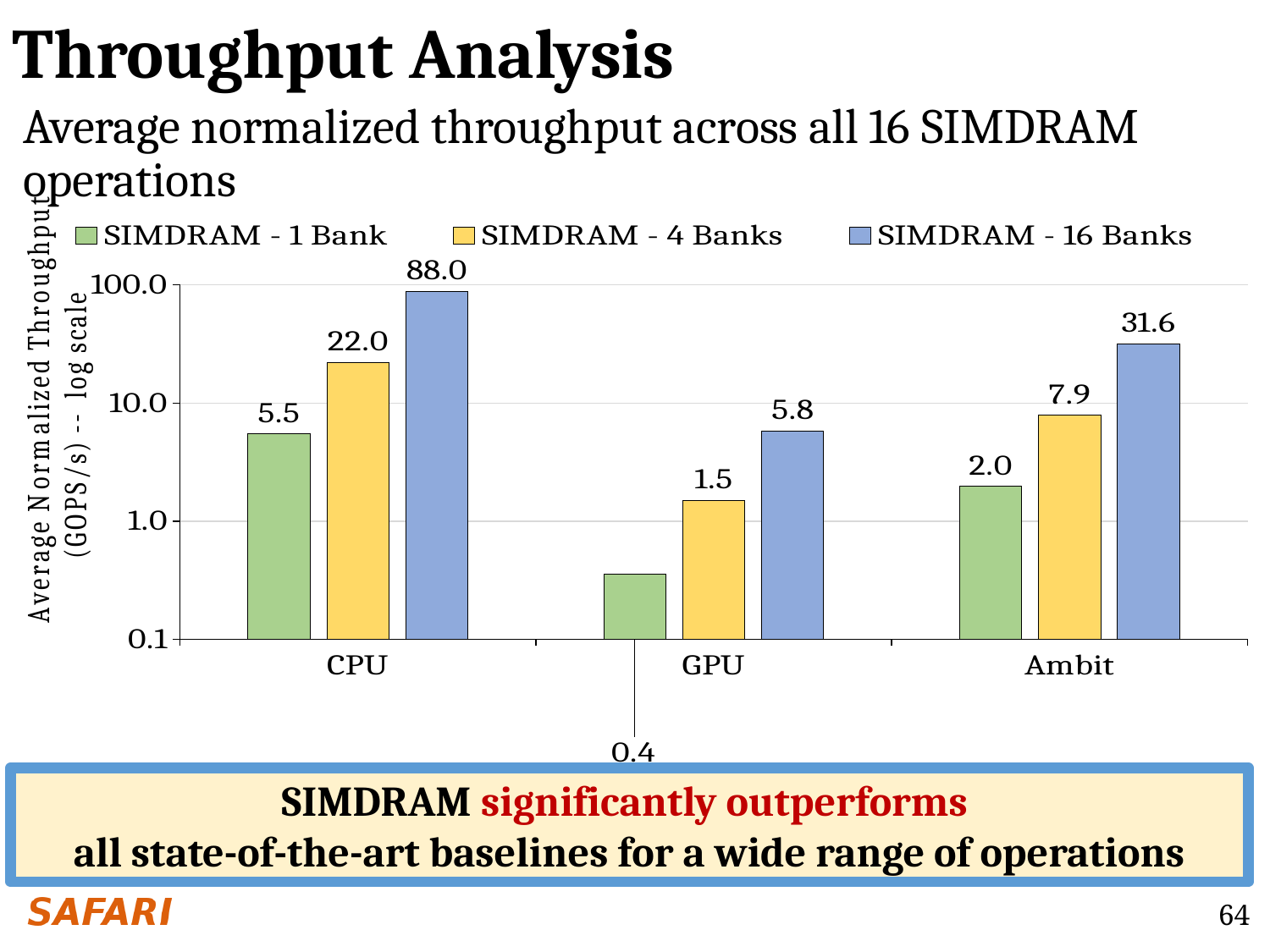
Which category has the highest value for SIMDRAM - 16 Banks? CPU What is the value for SIMDRAM - 1 Bank for Ambit? 2.0 What is the difference between the SIMDRAM - 16 Banks value for Ambit and the SIMDRAM - 4 Banks value for Ambit? 23.7 What is the y-axis label of the chart? Average Normalized Throughput (GOPS/s) -- log scale What is the value for SIMDRAM - 16 Banks for CPU? 88.0 How many series does the legend list? 3 What is the value for SIMDRAM - 1 Bank for GPU? 0.4 What is the value for SIMDRAM - 4 Banks for GPU? 1.5 Which category has the lowest value for SIMDRAM - 4 Banks? GPU What type of chart is shown on the slide? bar chart How many categories are shown on the x axis? 3 Which is larger: the SIMDRAM - 16 Banks value for GPU or the SIMDRAM - 4 Banks value for Ambit? SIMDRAM - 4 Banks value for Ambit